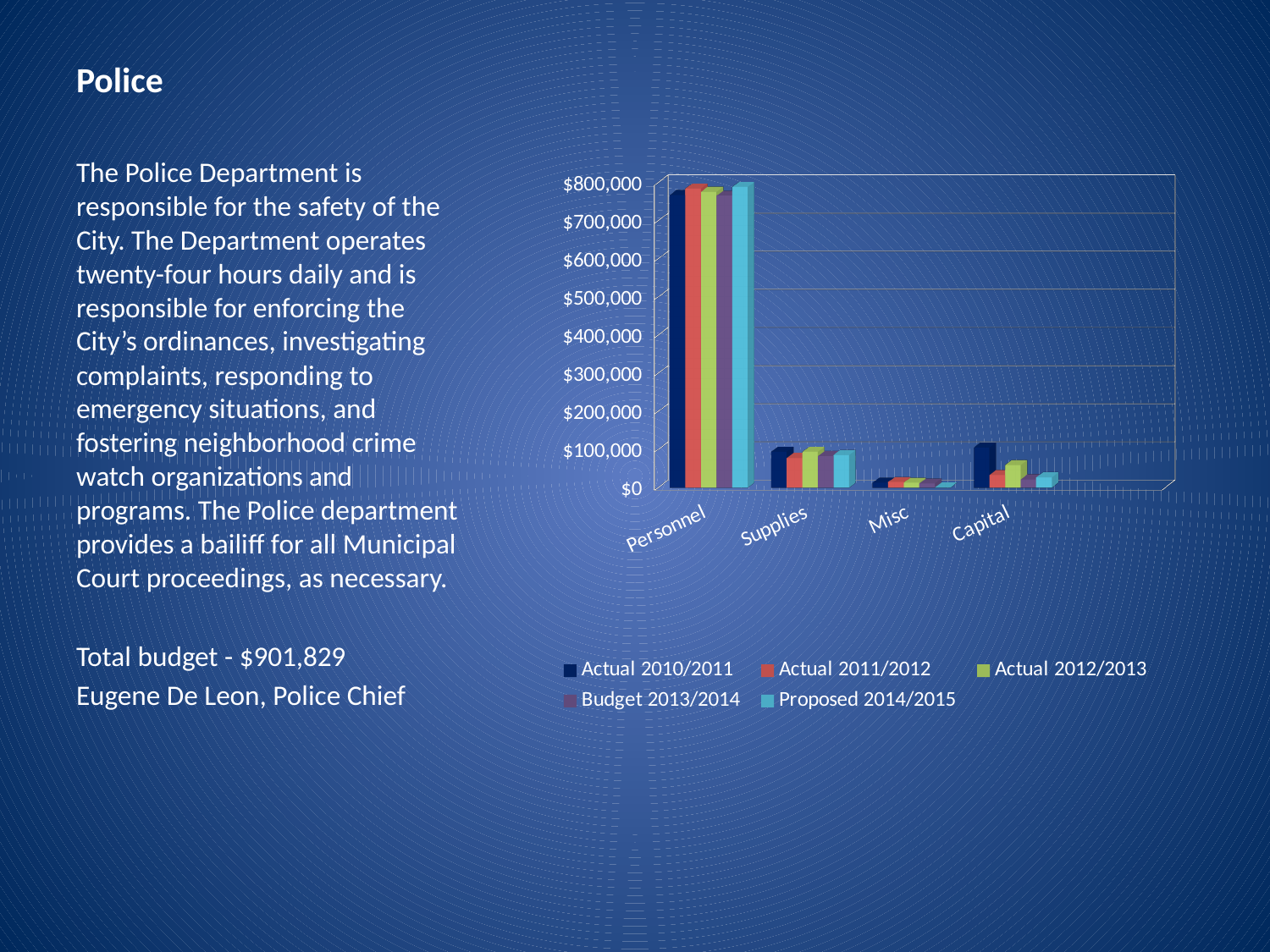
Which category has the lowest values in the chart? Misc How many series does the chart's legend list? 5 Is the Misc value for Actual 2012/2013 greater or less than $100,000? less Is the Capital value for Proposed 2014/2015 greater or less than $100,000? less Which category has the highest values in the chart? Personnel For Proposed 2014/2015, which is larger: Personnel or Supplies? Personnel Is the Personnel value for Actual 2010/2011 greater or less than $700,000? greater For Capital, which is larger: Actual 2010/2011 or Proposed 2014/2015? Actual 2010/2011 Which series is shown in the legend as Budget 2013/2014's neighbour to the right? Proposed 2014/2015 How many categories are shown on the x axis of the chart? 4 What kind of chart is shown on the slide? Bar chart